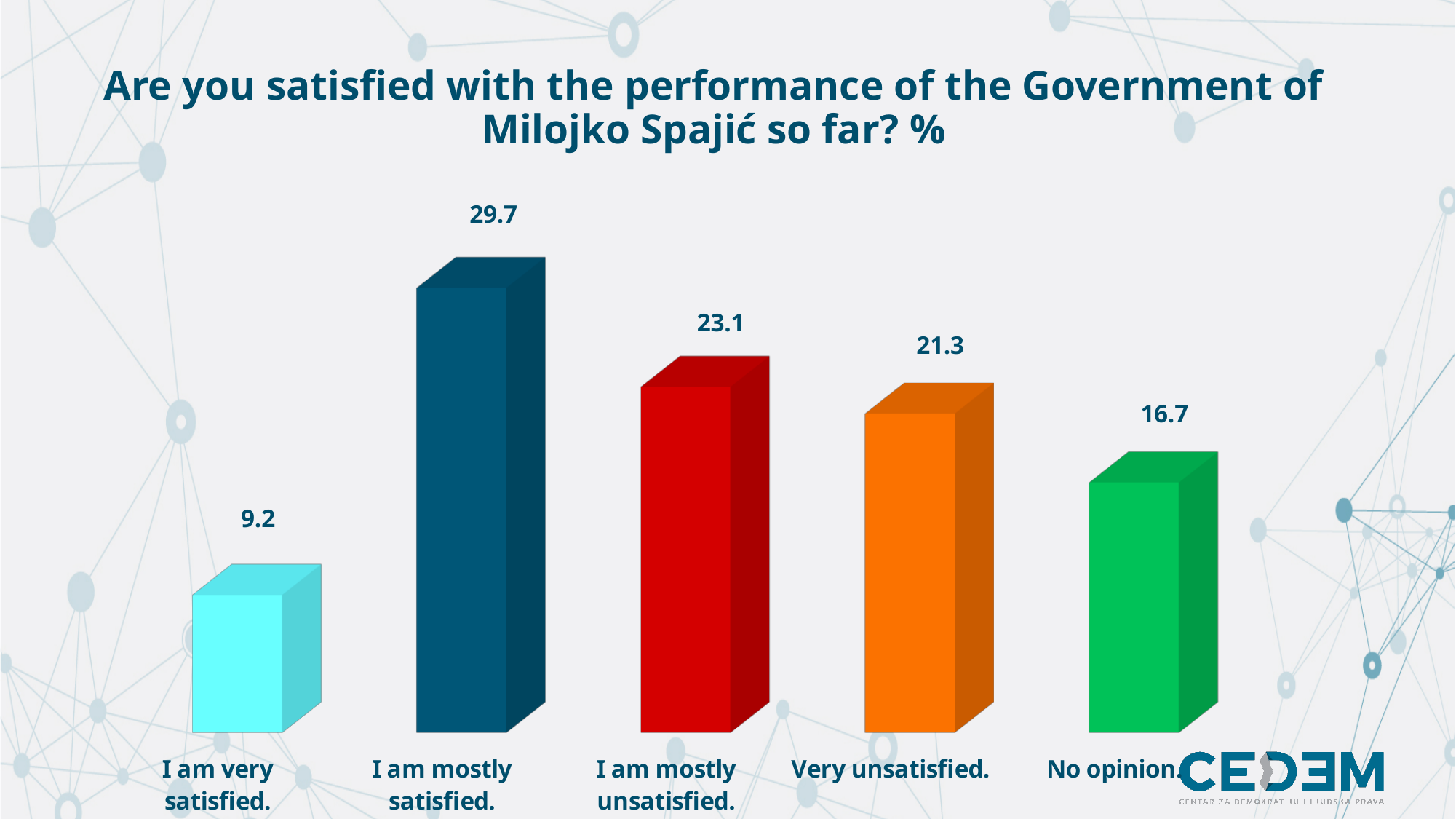
How many categories are shown in the chart? 5 What kind of chart is shown on the slide? Bar chart Which category has the lowest value? I am very satisfied. What is the difference between "Very unsatisfied." and "No opinion."? 4.6 What is the value for "No opinion."? 16.7 What is the value for "Very unsatisfied."? 21.3 What is the value for "I am mostly satisfied."? 29.7 What is the value for "I am very satisfied."? 9.2 What colour is the bar for "I am mostly unsatisfied."? Red What is the difference between "I am mostly satisfied." and "I am mostly unsatisfied."? 6.6 Which is larger, "I am mostly unsatisfied." or "Very unsatisfied."? I am mostly unsatisfied. Which category has the highest value? I am mostly satisfied.